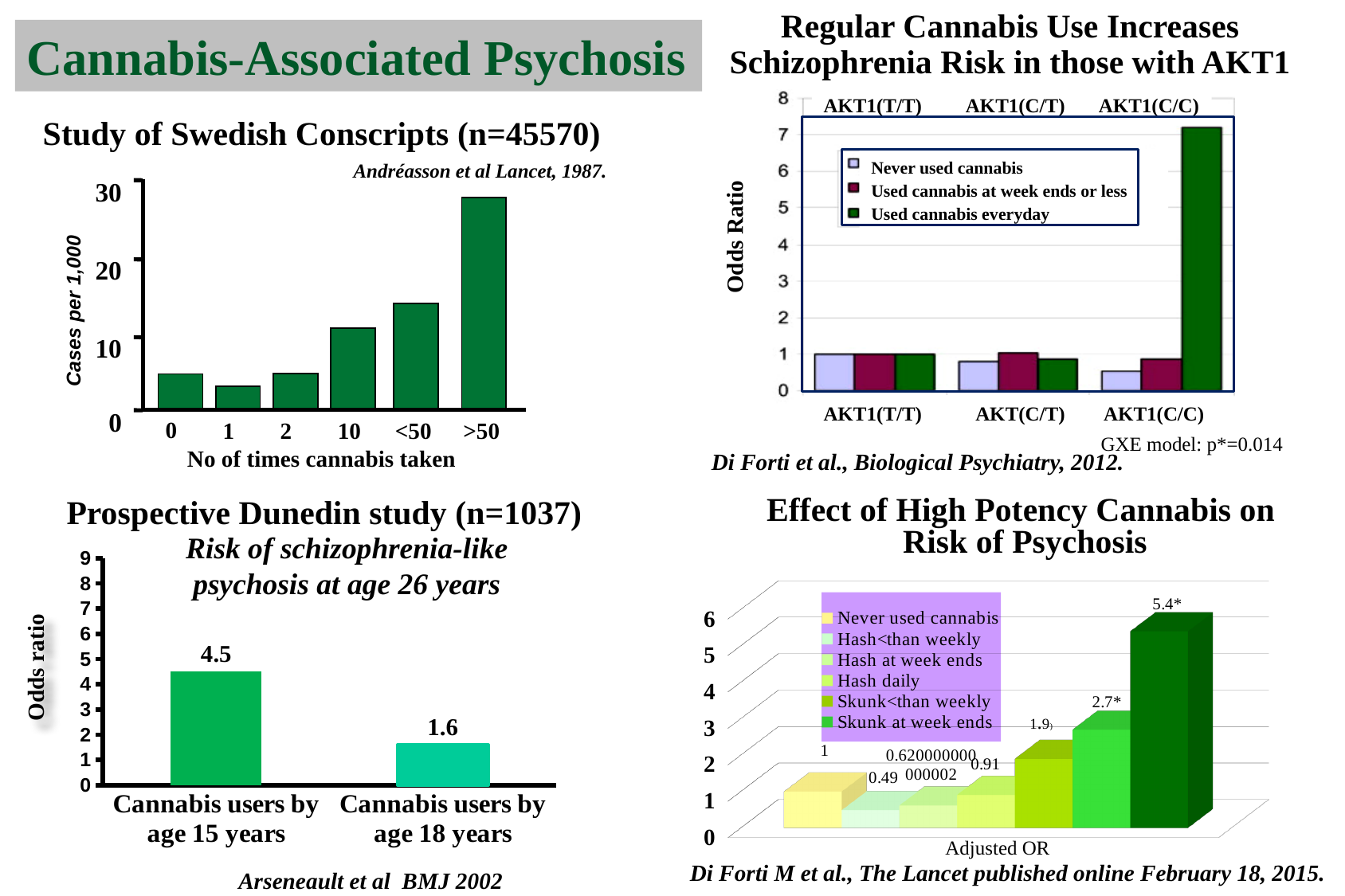
In the Prospective Dunedin study chart, what is the difference between the odds ratios for cannabis users by age 15 years and by age 18 years? 2.9 In the Study of Swedish Conscripts chart, which category of number of times cannabis taken has the lowest cases per 1,000? 1 In the Study of Swedish Conscripts chart, is the value for >50 greater or less than 20 cases per 1,000? greater In the Prospective Dunedin study chart, what is the odds ratio for cannabis users by age 18 years? 1.6 How many categories are shown on the x axis of the Study of Swedish Conscripts chart? 6 What kind of chart is the Prospective Dunedin study chart? bar chart In the chart titled 'Effect of High Potency Cannabis on Risk of Psychosis', what is the highest adjusted OR value labelled on a bar? 5.4* In the chart titled 'Regular Cannabis Use Increases Schizophrenia Risk in those with AKT1', is the odds ratio for 'Used cannabis everyday' in the AKT1(C/C) group greater or less than 5? greater In the Study of Swedish Conscripts chart, which category of number of times cannabis taken has the highest cases per 1,000? >50 In the chart titled 'Regular Cannabis Use Increases Schizophrenia Risk in those with AKT1', which genotype group has the highest odds ratio for 'Used cannabis everyday'? AKT1(C/C) How many series does the legend list in the chart titled 'Regular Cannabis Use Increases Schizophrenia Risk in those with AKT1'? 3 In the Prospective Dunedin study chart, what is the odds ratio for cannabis users by age 15 years? 4.5